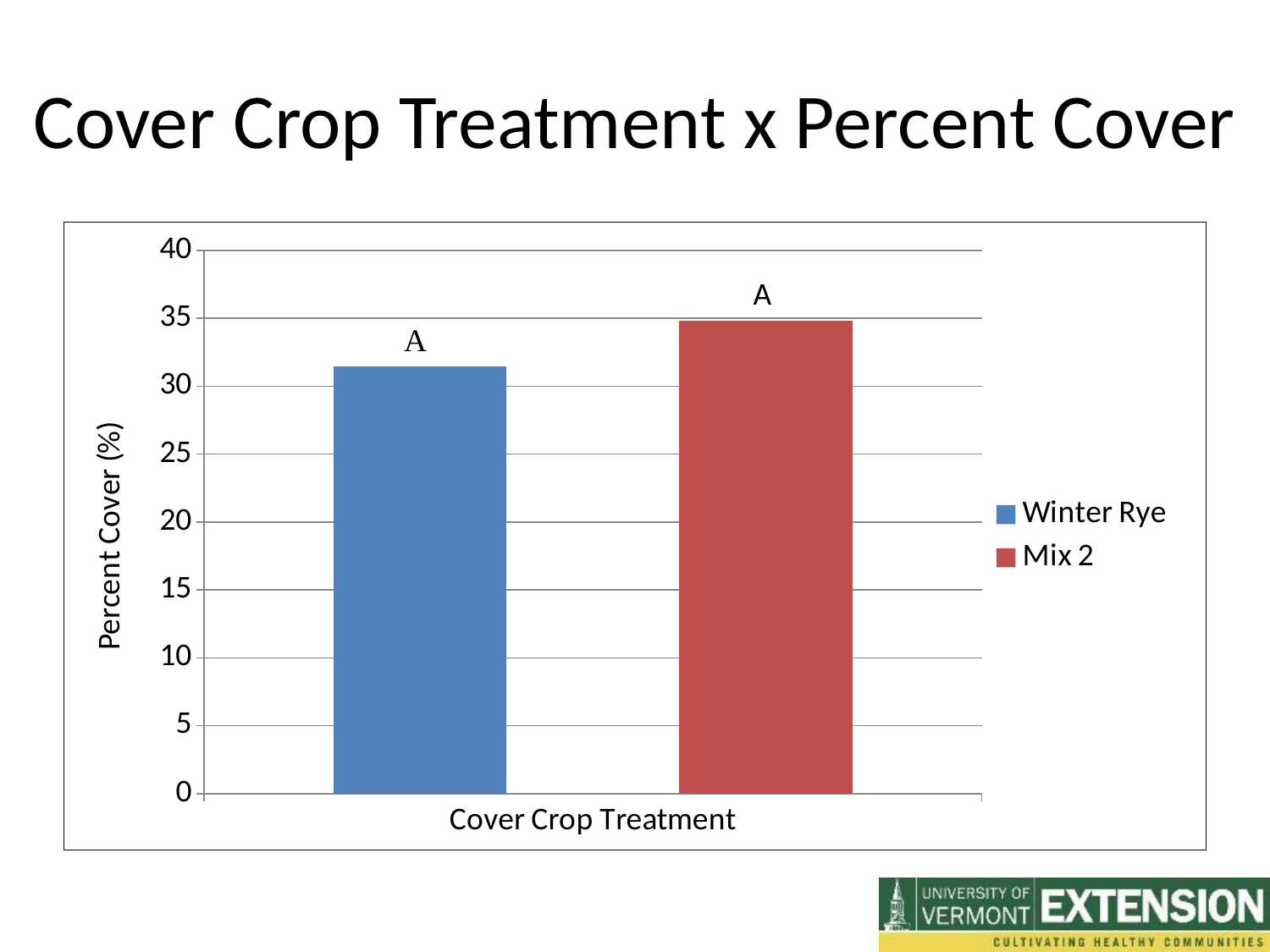
Which colour represents Mix 2 in the legend? red What is the label on the vertical axis of the chart? Percent Cover (%) Is the value for Winter Rye greater or less than 35? less Which cover crop treatment has the lower percent cover? Winter Rye How many series does the legend list? 2 What kind of chart is shown on the slide? bar chart Is the value for Mix 2 greater or less than 40? less Which cover crop treatment has the higher percent cover? Mix 2 Is the value for Mix 2 greater or less than 30? greater Is the percent cover for Mix 2 larger or smaller than that for Winter Rye? larger How many bars are plotted in the chart? 2